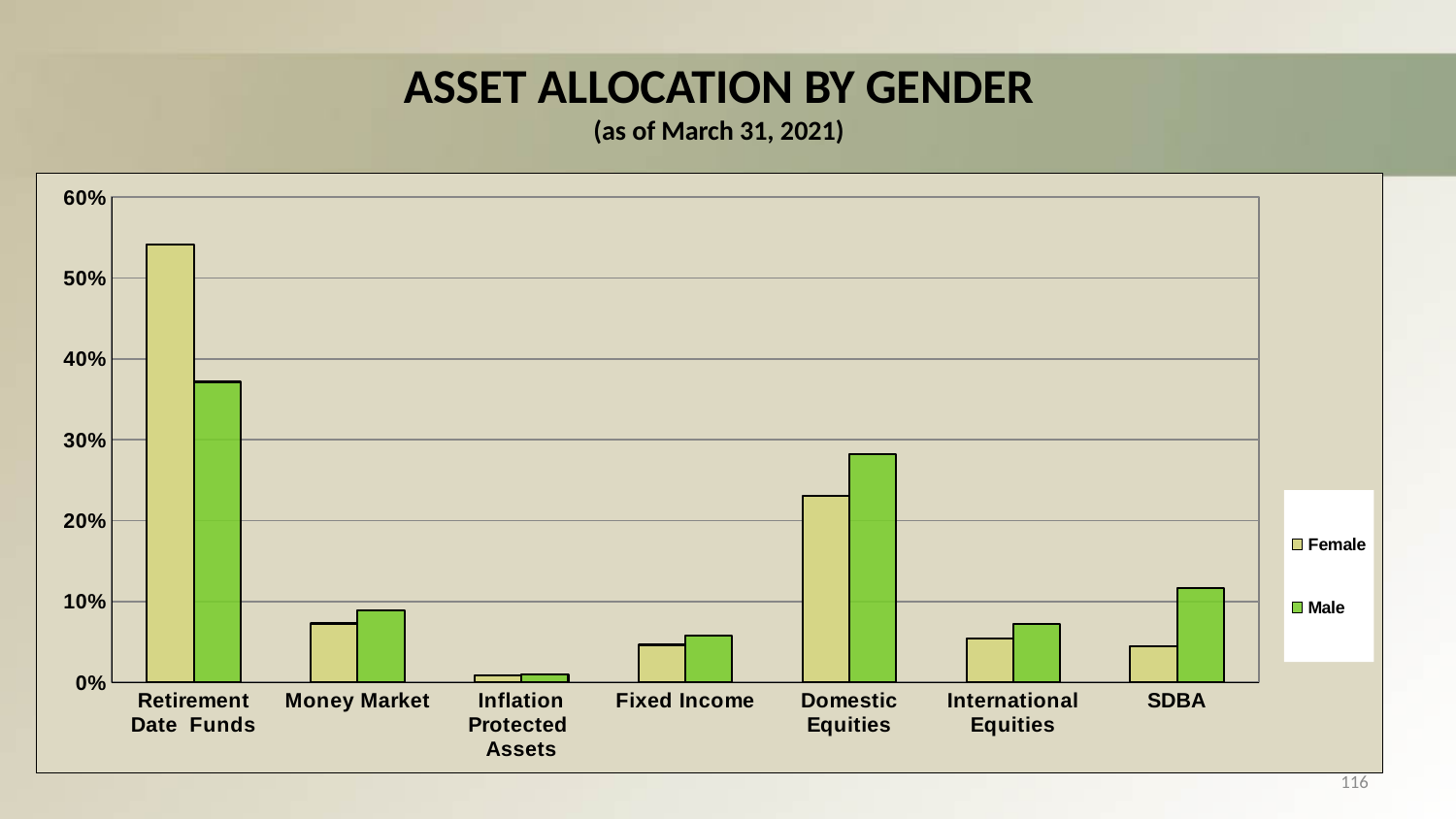
Is the Male value for Retirement Date Funds greater or less than 40%? less As of what date is the asset allocation data shown? March 31, 2021 For SDBA, which is larger, the Female or the Male allocation? Male Which asset category has the highest Male allocation? Retirement Date Funds What kind of chart is shown on the slide? Bar chart Which asset category has the lowest Male allocation? Inflation Protected Assets How many asset categories are shown on the x axis? 7 How many series does the legend list? 2 For Retirement Date Funds, which is larger, the Female or the Male allocation? Female Is the Male value for Domestic Equities greater or less than 20%? greater Is the Female value for Retirement Date Funds greater or less than 50%? greater Which asset category has the highest Female allocation? Retirement Date Funds